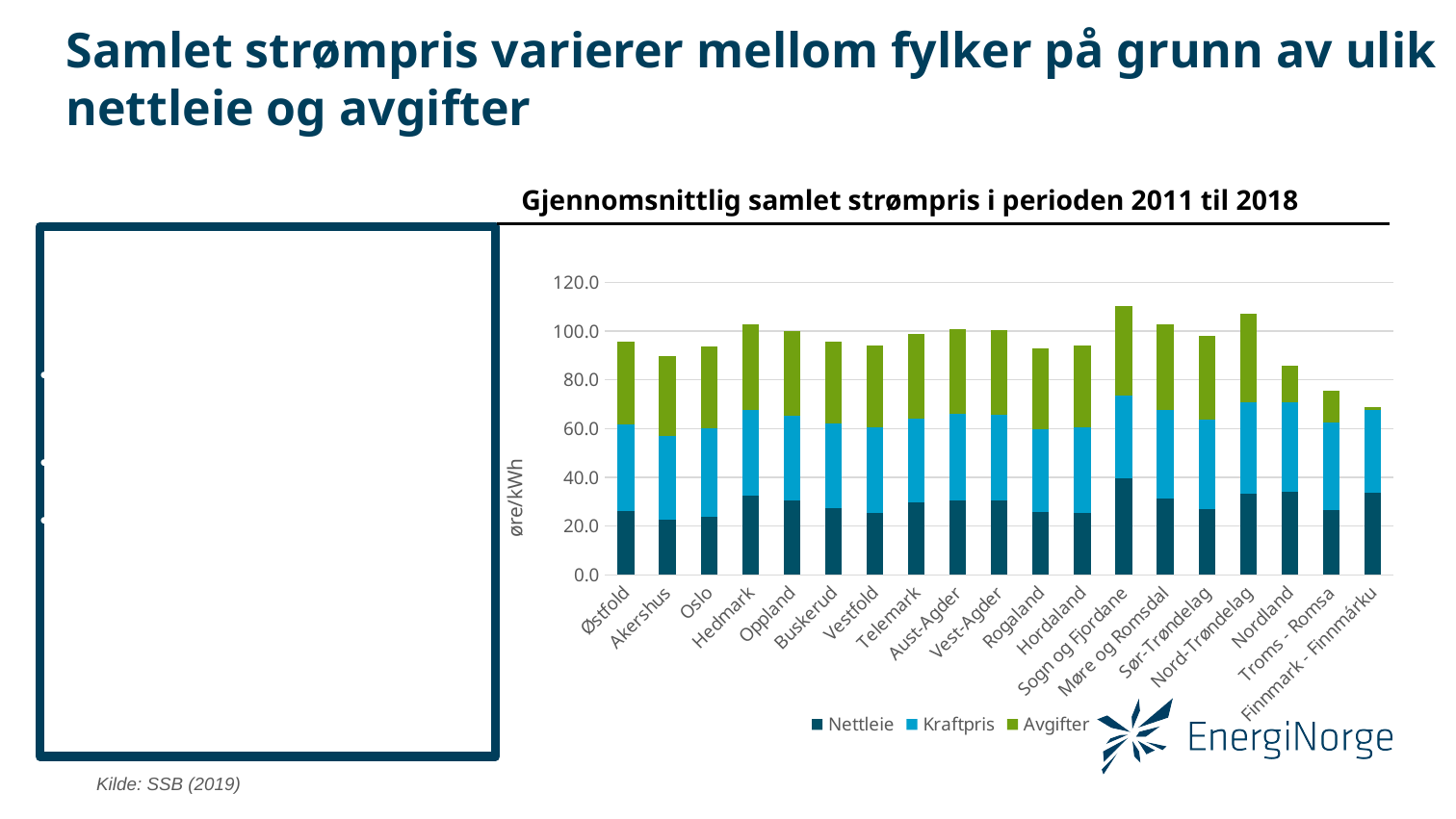
Is the total value for Akershus greater or less than 100? less Which county has the highest total average electricity price? Sogn og Fjordane What kind of chart is shown on the slide? Stacked bar chart Which county has the lowest total average electricity price? Finnmark - Finnmárku What unit is shown on the y axis of the chart? øre/kWh Which has the larger total value, Nordland or Troms - Romsa? Nordland Is the total value for Finnmark - Finnmárku greater or less than 80? less Is the total value for Sogn og Fjordane greater or less than 100? greater How many series does the legend list? 3 How many counties (categories) are shown on the x axis? 19 What is the title of the chart? Gjennomsnittlig samlet strømpris i perioden 2011 til 2018